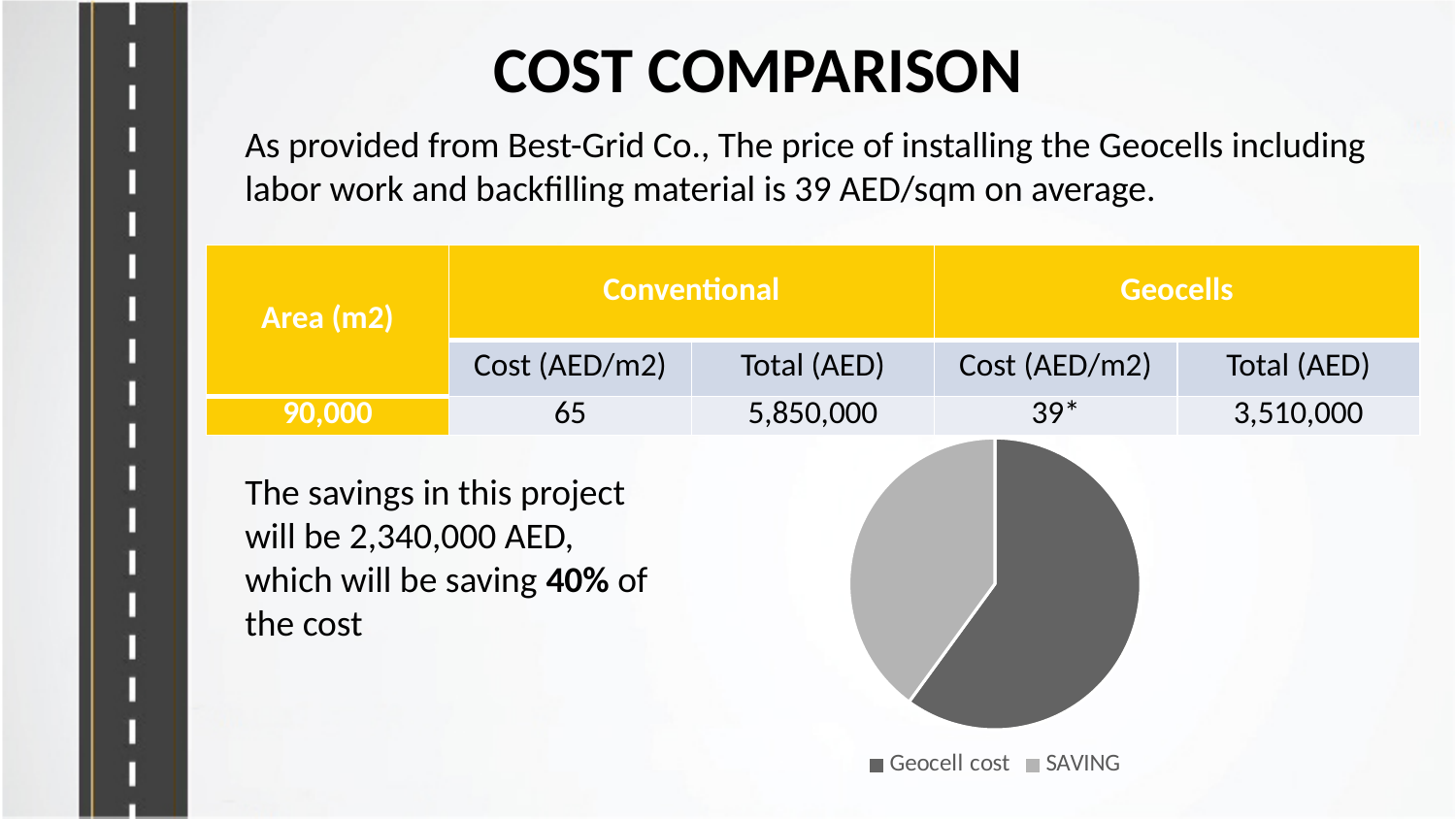
What are the two legend entries of the pie chart? Geocell cost and SAVING What kind of chart is shown on the slide? pie chart Which slice of the pie chart is the smallest? SAVING Which slice of the pie chart is larger, Geocell cost or SAVING? Geocell cost Which legend entry of the pie chart is shown in the darker grey colour? Geocell cost Which slice of the pie chart is the largest? Geocell cost What share of the pie chart does the SAVING slice represent, according to the slide? 40% How many entries does the pie chart's legend list? 2 How many slices does the pie chart have? 2